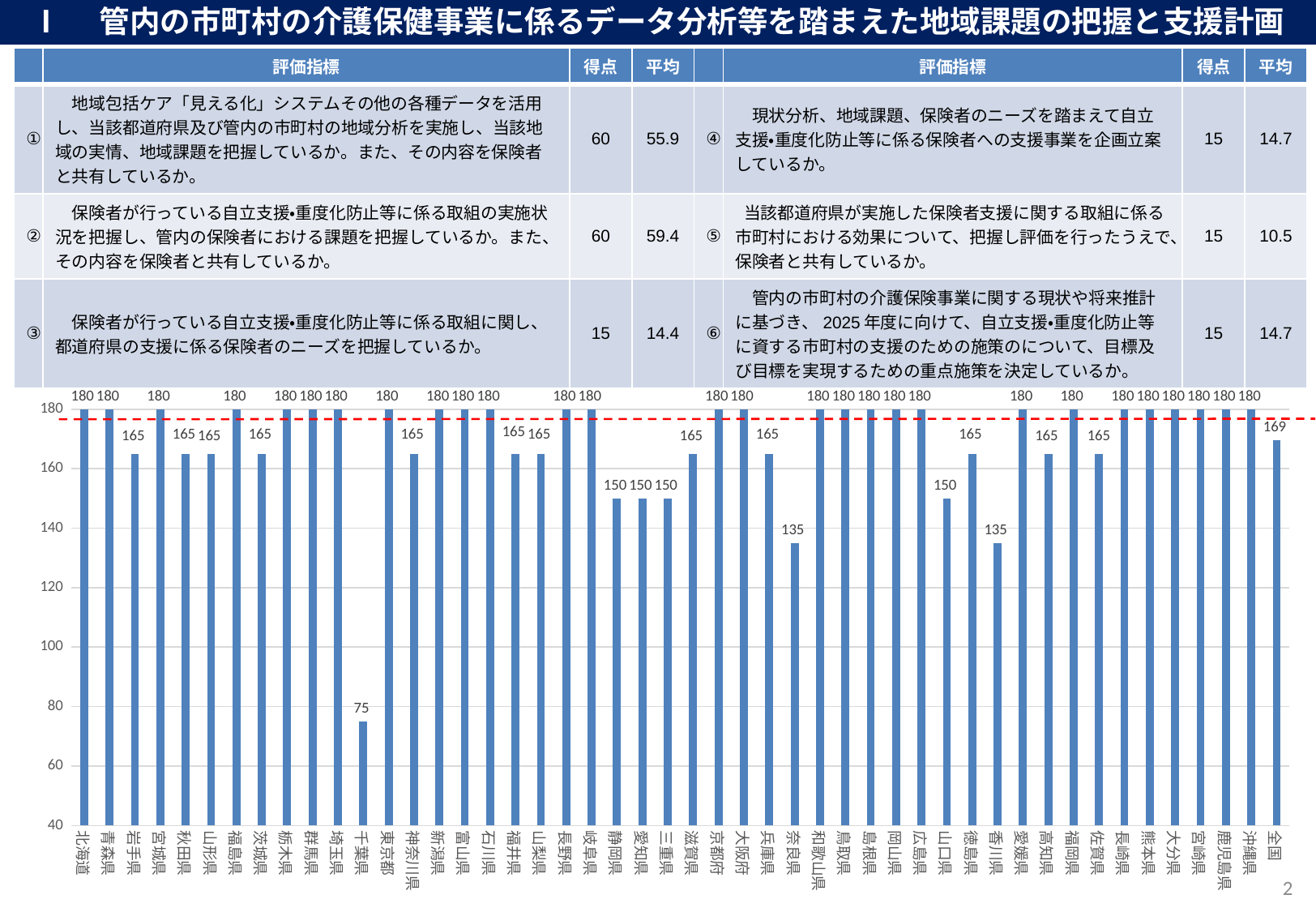
What is the value for 静岡県 in the bar chart? 150 Which category has the lowest value in the bar chart? 千葉県 What is the lowest value shown on the vertical axis of the bar chart? 40 What is the value for 千葉県 in the bar chart? 75 What is the difference between the values for 全国 and 千葉県? 94 How many bars are plotted in the bar chart? 48 Which has a larger value, 徳島県 or 香川県? 徳島県 What kind of chart is shown at the bottom of the slide? bar chart What is the value for 全国 in the bar chart? 169 What is the value for 奈良県 in the bar chart? 135 Is the value for 千葉県 greater or less than 80? less What is the difference between the values for 北海道 and 奈良県? 45